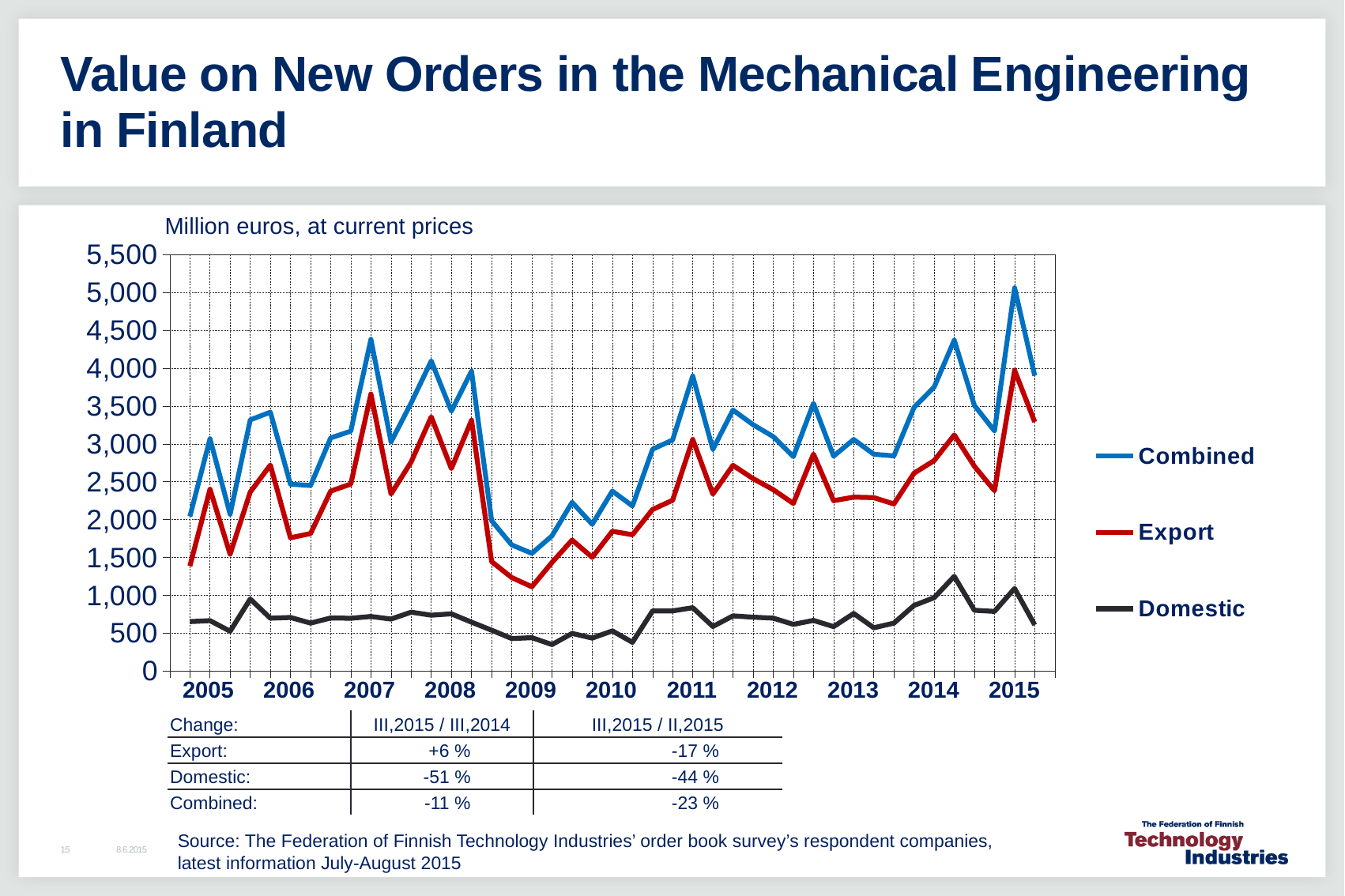
What are the three series named in the legend? Combined, Export, Domestic Is the highest value of the Domestic series greater or less than 1,500? less In which year does the Export series reach its lowest point? 2009 Which series has the lowest values across the whole period? Domestic How many series does the legend list? 3 Which series has the highest values across the whole period? Combined Is the peak value of the Combined series in 2015 greater or less than 4,500? greater In which year does the Combined series reach its highest peak? 2015 How many years are labelled on the x axis? 11 What unit is stated above the chart's y axis? Million euros, at current prices Does the Combined series rise or fall from 2008 to 2009? fall What kind of chart is shown on the slide? line chart